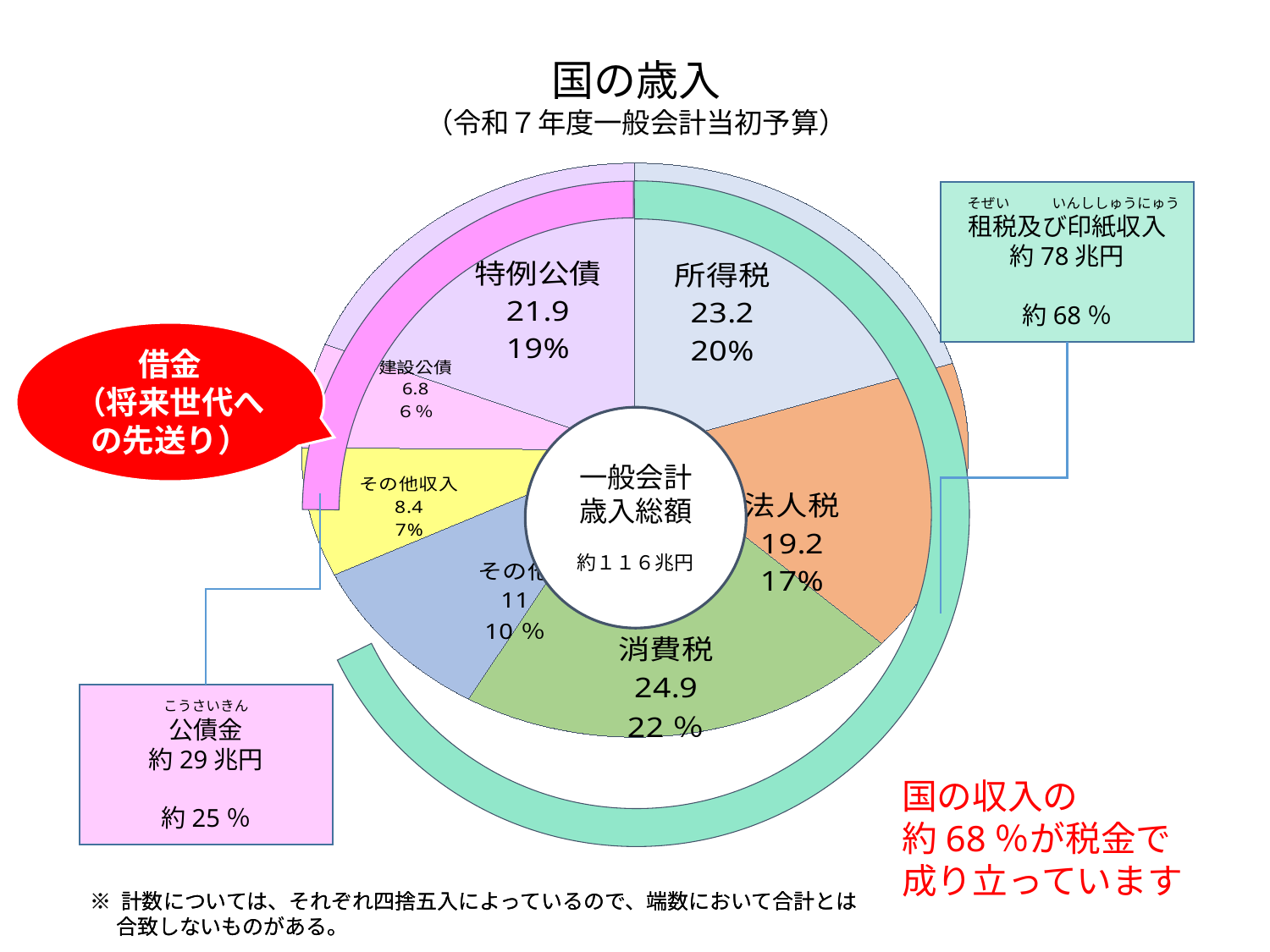
Which is larger, 所得税 or 法人税? 所得税 What total is shown in the centre of the pie chart? 約１１６兆円 What kind of chart is shown on the slide? pie chart What is the value shown for 所得税? 23.2 What percentage share of the pie does 消費税 have? 22% Which slice has the largest value? 消費税 What is the value shown for 特例公債? 21.9 Which slice has the smallest value? 建設公債 What is the value shown for 建設公債? 6.8 How many slices does the pie chart have? 7 What is the difference between the values for 消費税 and 所得税? 1.7 What is the value shown for 法人税? 19.2